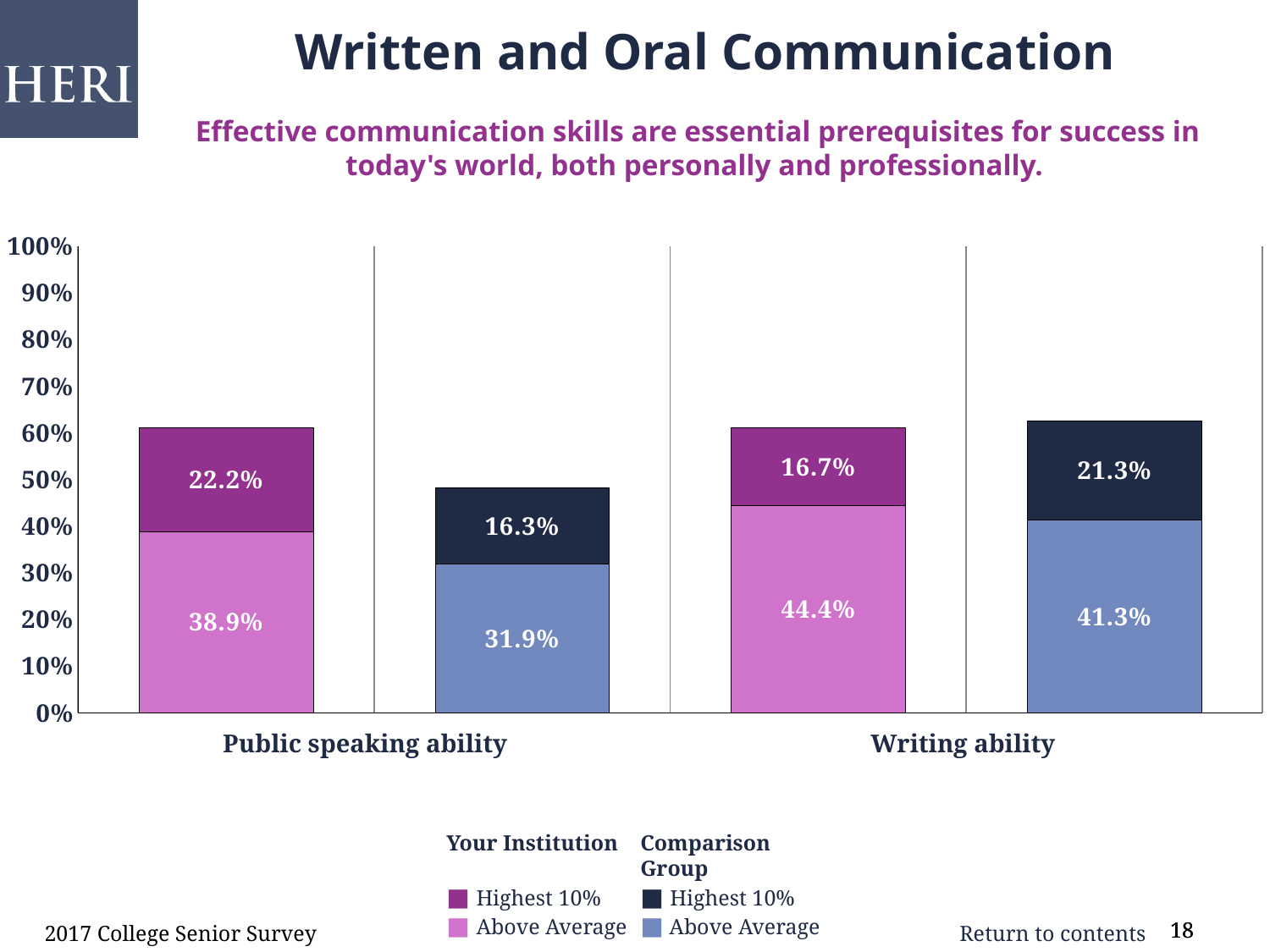
Which is larger for writing ability: the Your Institution Highest 10% value or the Comparison Group Highest 10% value? Comparison Group Highest 10% How many entries does the legend list? 4 What is the total height of the Comparison Group stacked bar for writing ability? 62.6% What percentage of Your Institution students rated their public speaking ability as Above Average? 38.9% What is the difference between the Your Institution and Comparison Group Above Average values for public speaking ability? 7.0% What is the Your Institution Highest 10% value for public speaking ability? 22.2% Which Above Average segment is the largest across all bars? Your Institution, Writing ability (44.4%) What is the Comparison Group's Above Average value for public speaking ability? 31.9% What type of chart is shown on the slide? Stacked bar chart What is the total height of the Your Institution stacked bar for public speaking ability? 61.1% Which Highest 10% segment is the smallest across all bars? Comparison Group, Public speaking ability (16.3%) What is the Comparison Group's Highest 10% value for writing ability? 21.3%